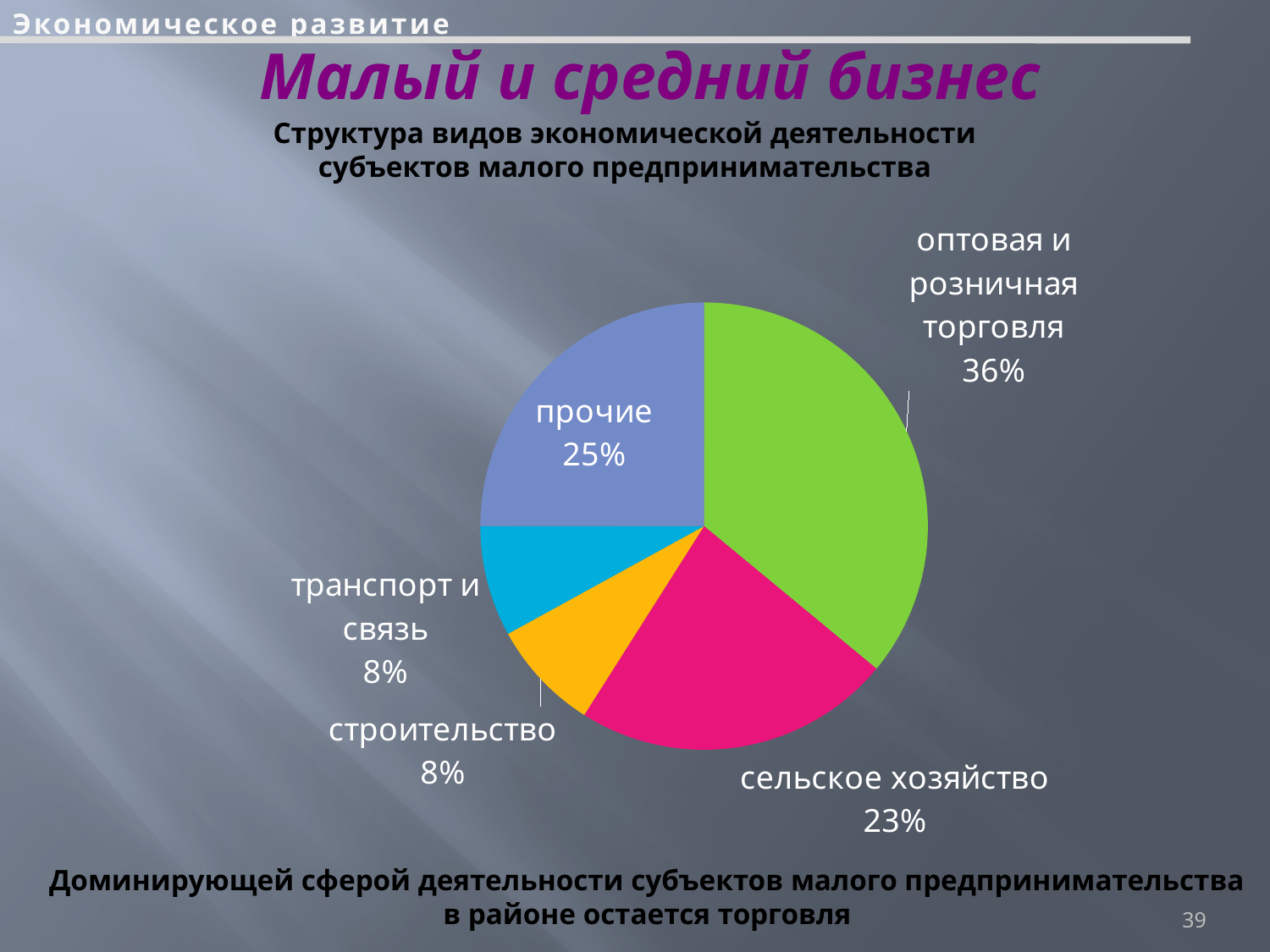
What share of the pie does "строительство" have? 8% Which category has the largest share of the pie? оптовая и розничная торговля What share of the pie does "оптовая и розничная торговля" have? 36% What kind of chart is shown on the slide? pie chart What share of the pie does "прочие" have? 25% How many slices does the pie chart have? 5 What share of the pie does "транспорт и связь" have? 8% What is the difference in percentage points between "оптовая и розничная торговля" and "сельское хозяйство"? 13 What is the difference in percentage points between "прочие" and "строительство"? 17 What share of the pie does "сельское хозяйство" have? 23% What is the title of the chart shown on the slide? Структура видов экономической деятельности субъектов малого предпринимательства Which is larger, the share for "прочие" or the share for "сельское хозяйство"? прочие